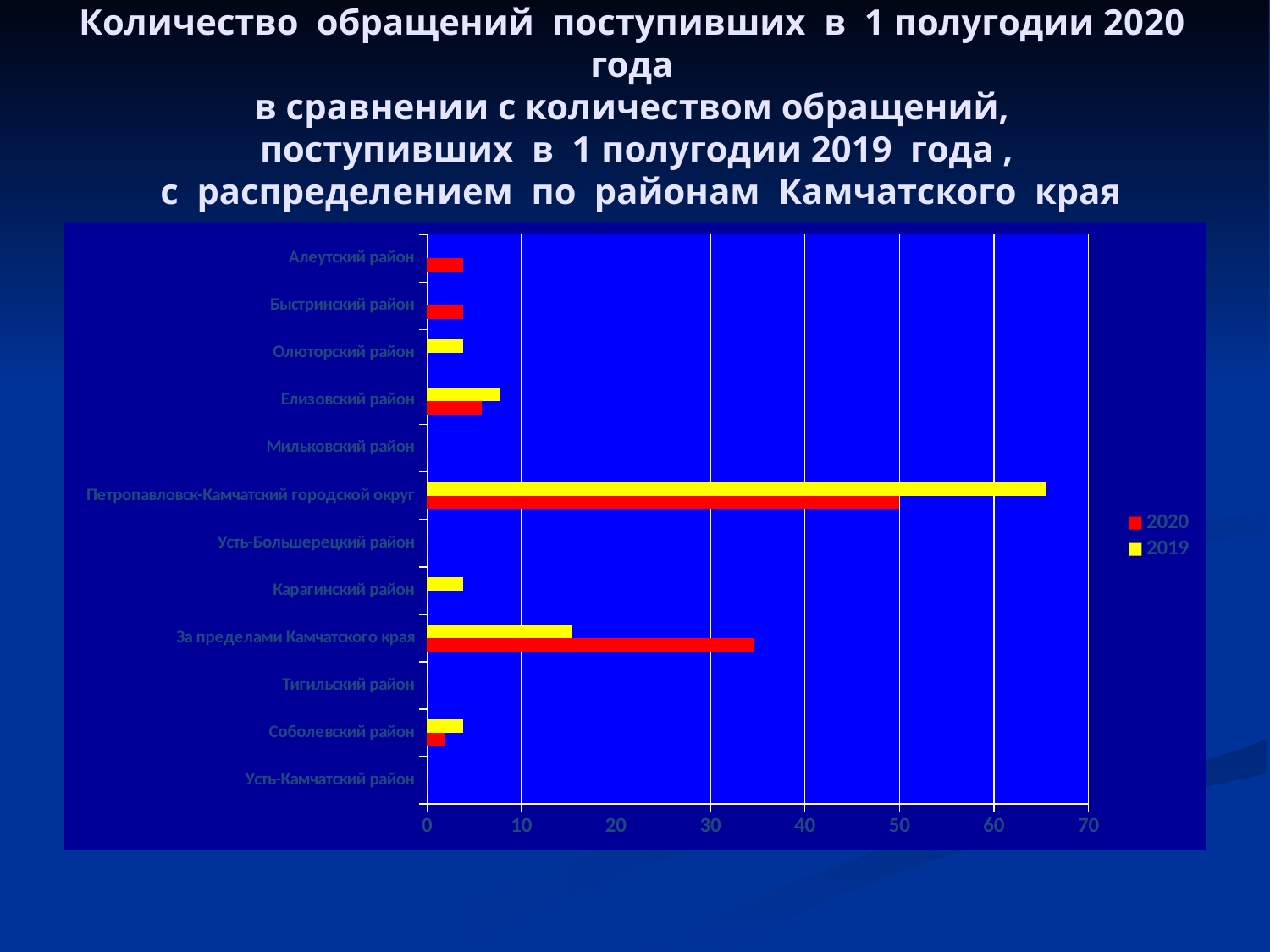
Which category has the highest value for the 2019 series? Петропавловск-Камчатский городской округ How many series does the legend list? 2 Is the 2019 value for За пределами Камчатского края greater or less than 20? less For Петропавловск-Камчатский городской округ, which series has the larger value, 2020 or 2019? 2019 Is the 2019 value for Петропавловск-Камчатский городской округ greater or less than 60? greater Which colour represents the 2019 series in the legend? yellow For За пределами Камчатского края, which series has the larger value, 2020 or 2019? 2020 Which category has the highest value for the 2020 series? Петропавловск-Камчатский городской округ Is the 2020 value for За пределами Камчатского края greater or less than 30? greater Which colour represents the 2020 series in the legend? red How many categories (districts) are listed on the vertical axis of the chart? 12 What kind of chart is shown on the slide? bar chart